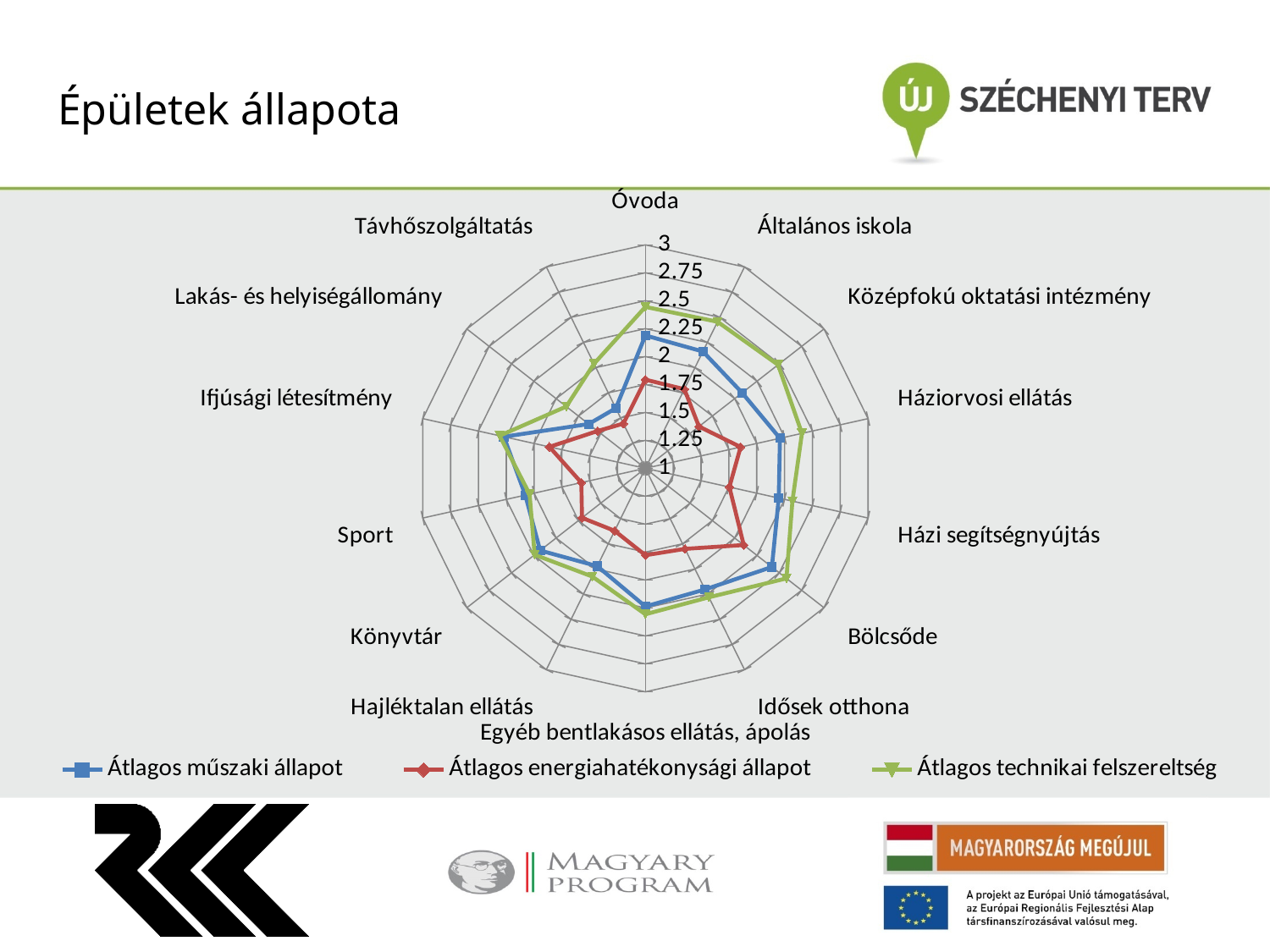
What kind of chart is shown on the slide? Radar chart How many categories (axes) does the radar chart have? 14 Is the value of Átlagos energiahatékonysági állapot for Óvoda greater or less than 2? less Is the value of Átlagos energiahatékonysági állapot for Sport greater or less than 2? less Is the value of Átlagos technikai felszereltség for Óvoda greater or less than 2? greater For Óvoda, which is larger: Átlagos technikai felszereltség or Átlagos energiahatékonysági állapot? Átlagos technikai felszereltség For Háziorvosi ellátás, which is larger: Átlagos műszaki állapot or Átlagos energiahatékonysági állapot? Átlagos műszaki állapot What is the maximum value shown on the radial axis? 3 How many series does the legend list? 3 Which series is shown with the red diamond markers? Átlagos energiahatékonysági állapot